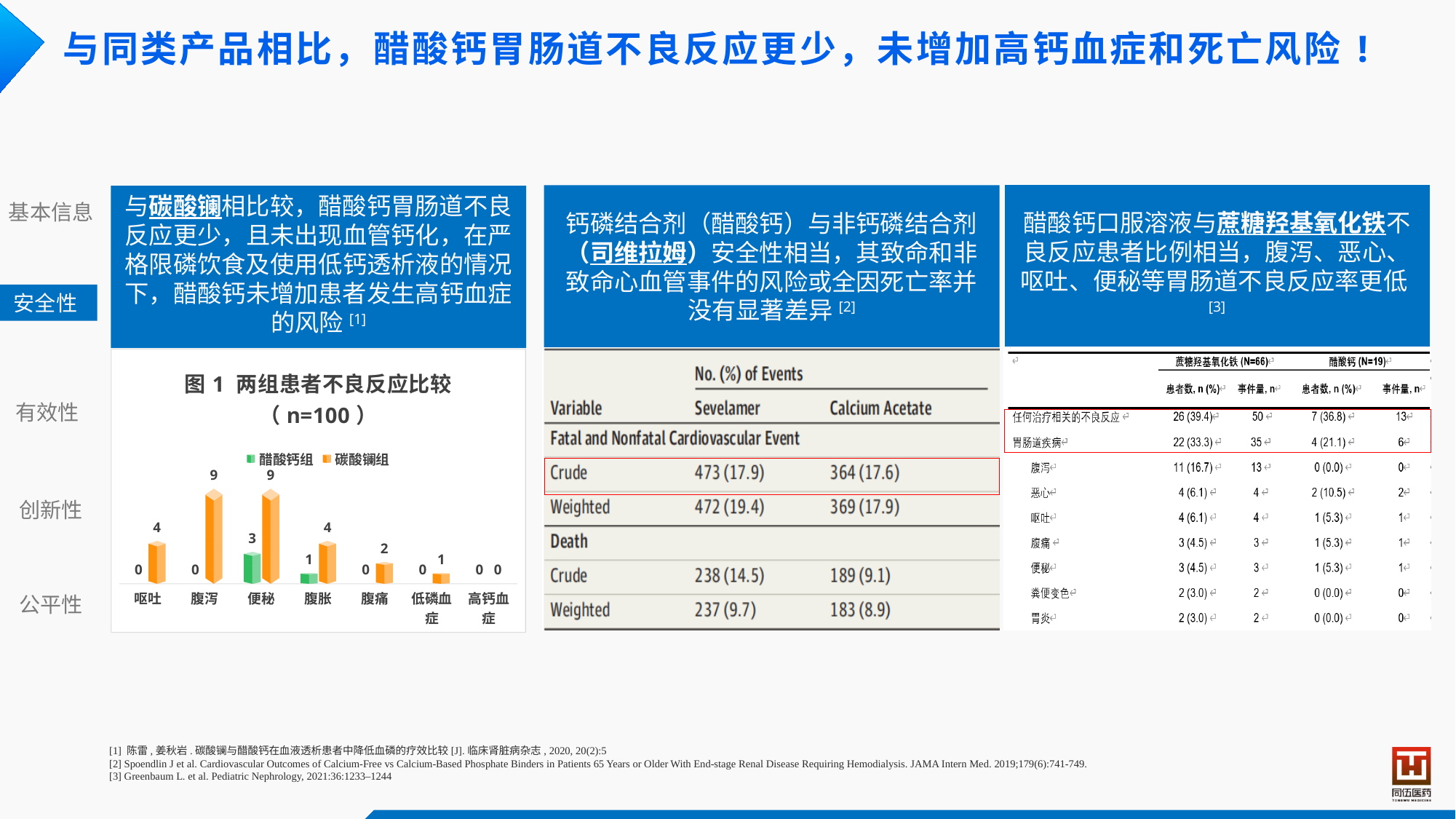
How many series does the legend of 图 1 list? 2 How many categories are shown on the x axis of 图 1? 7 What kind of chart is 图 1? Bar chart In 图 1, what is the difference between 碳酸镧组 and 醋酸钙组 in the 便秘 category? 6 In 图 1, what is the value for 碳酸镧组 in the 呕吐 category? 4 In 图 1, which group has the larger value in the 腹胀 category, 醋酸钙组 or 碳酸镧组? 碳酸镧组 In 图 1, what is the value for 醋酸钙组 in the 便秘 category? 3 In 图 1, what is the value for 碳酸镧组 in the 高钙血症 category? 0 In 图 1, which category has the highest value for 醋酸钙组? 便秘 In 图 1, what is the value for 碳酸镧组 in the 腹泻 category? 9 What is the sample size stated in the title of 图 1? n=100 In 图 1, what is the value for 醋酸钙组 in the 腹胀 category? 1